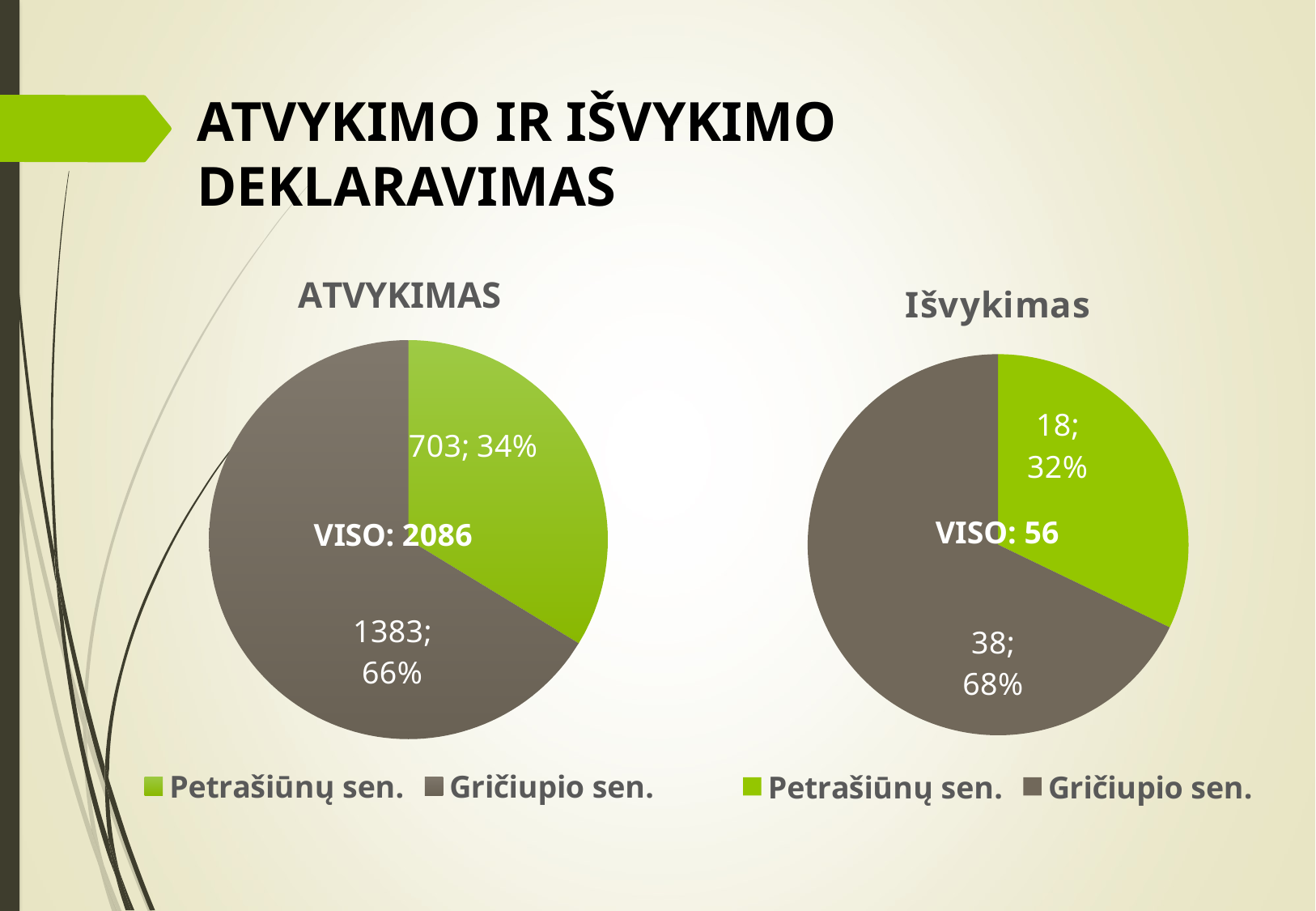
In the ATVYKIMAS chart, what share of the pie does Gričiupio sen. take? 66% In the ATVYKIMAS chart, what value is shown for Petrašiūnų sen.? 703 In the Išvykimas chart, what share of the pie does Petrašiūnų sen. take? 32% In the Išvykimas chart, which category has the smallest slice? Petrašiūnų sen. In the ATVYKIMAS chart, what is the difference between the values for Gričiupio sen. and Petrašiūnų sen.? 680 In the Išvykimas chart, what value is shown for Petrašiūnų sen.? 18 In the ATVYKIMAS chart, what value is shown for Gričiupio sen.? 1383 In the Išvykimas chart, what value is shown for Gričiupio sen.? 38 In the ATVYKIMAS chart, which category has the largest slice? Gričiupio sen. How many series does the legend of the Išvykimas chart list? 2 In the Išvykimas chart, what is the total shown for the pie (VISO)? 56 What kind of chart is the ATVYKIMAS chart? Pie chart